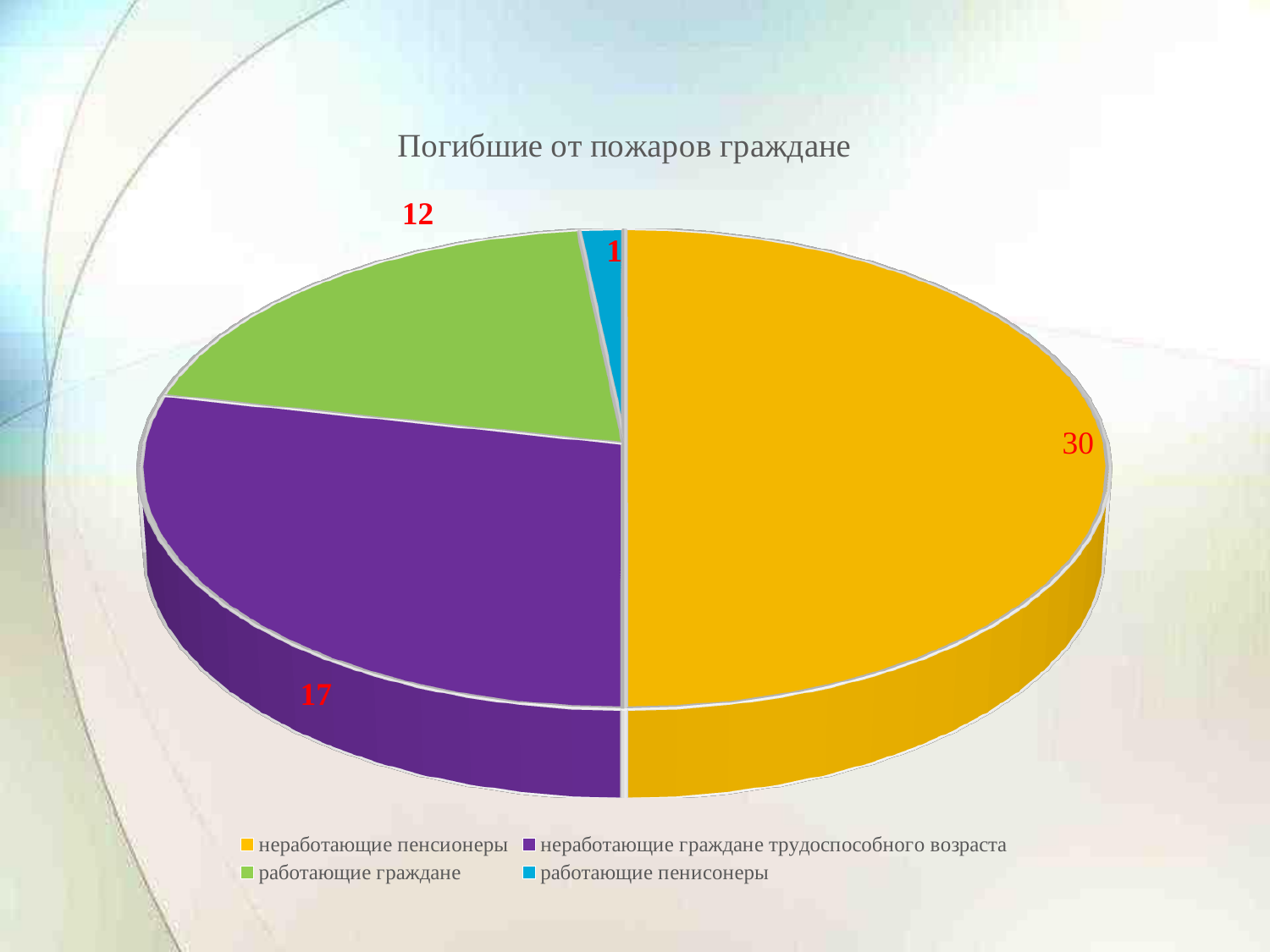
What is the value for неработающие граждане трудоспособного возраста? 17 What type of chart is shown on the slide? pie chart Which category has the smallest slice? работающие пенисонеры What is the value for работающие пенисонеры? 1 How many categories does the pie chart have? 4 Which category has the largest slice? неработающие пенсионеры What is the value for работающие граждане? 12 Which is larger: работающие граждане or неработающие граждане трудоспособного возраста? неработающие граждане трудоспособного возраста What is the difference between the values for неработающие пенсионеры and неработающие граждане трудоспособного возраста? 13 What share of the pie does неработающие пенсионеры represent? 50% What is the value for неработающие пенсионеры? 30 What is the title of the chart? Погибшие от пожаров граждане